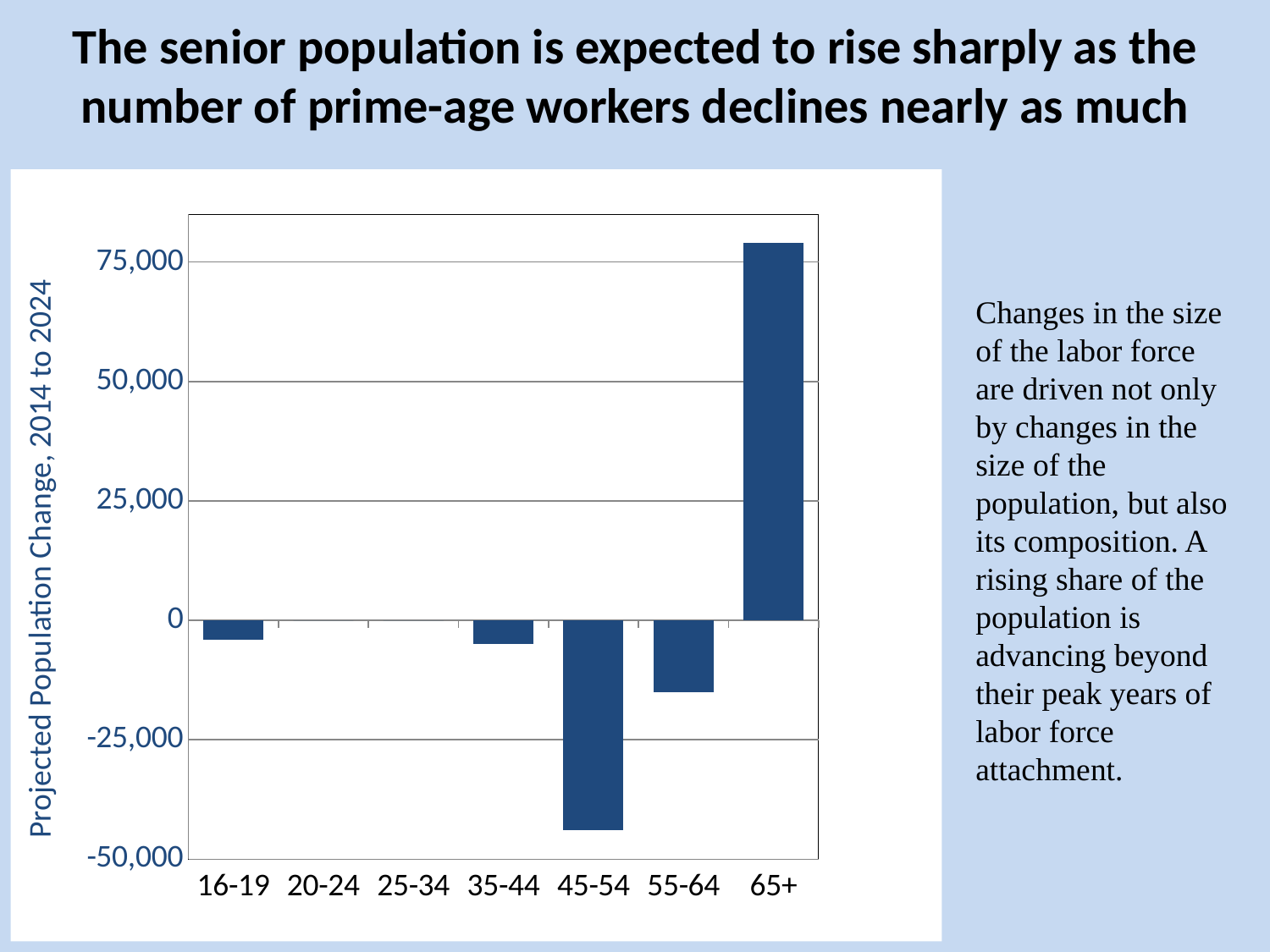
What is the lowest value shown on the vertical axis of the chart? -50,000 Which age group has the highest projected population change? 65+ Which age group has a larger projected population change, 45-54 or 55-64? 55-64 Which age group has a larger projected population change, 65+ or 16-19? 65+ What kind of chart is shown on the slide? bar chart Which age group has the lowest projected population change? 45-54 Is the projected population change for the 65+ age group greater or less than 75,000? greater Is the projected population change for the 65+ age group greater or less than 50,000? greater Is the projected population change for the 55-64 age group greater or less than -25,000? greater How many age groups are shown on the x axis of the chart? 7 What is the label on the vertical axis of the chart? Projected Population Change, 2014 to 2024